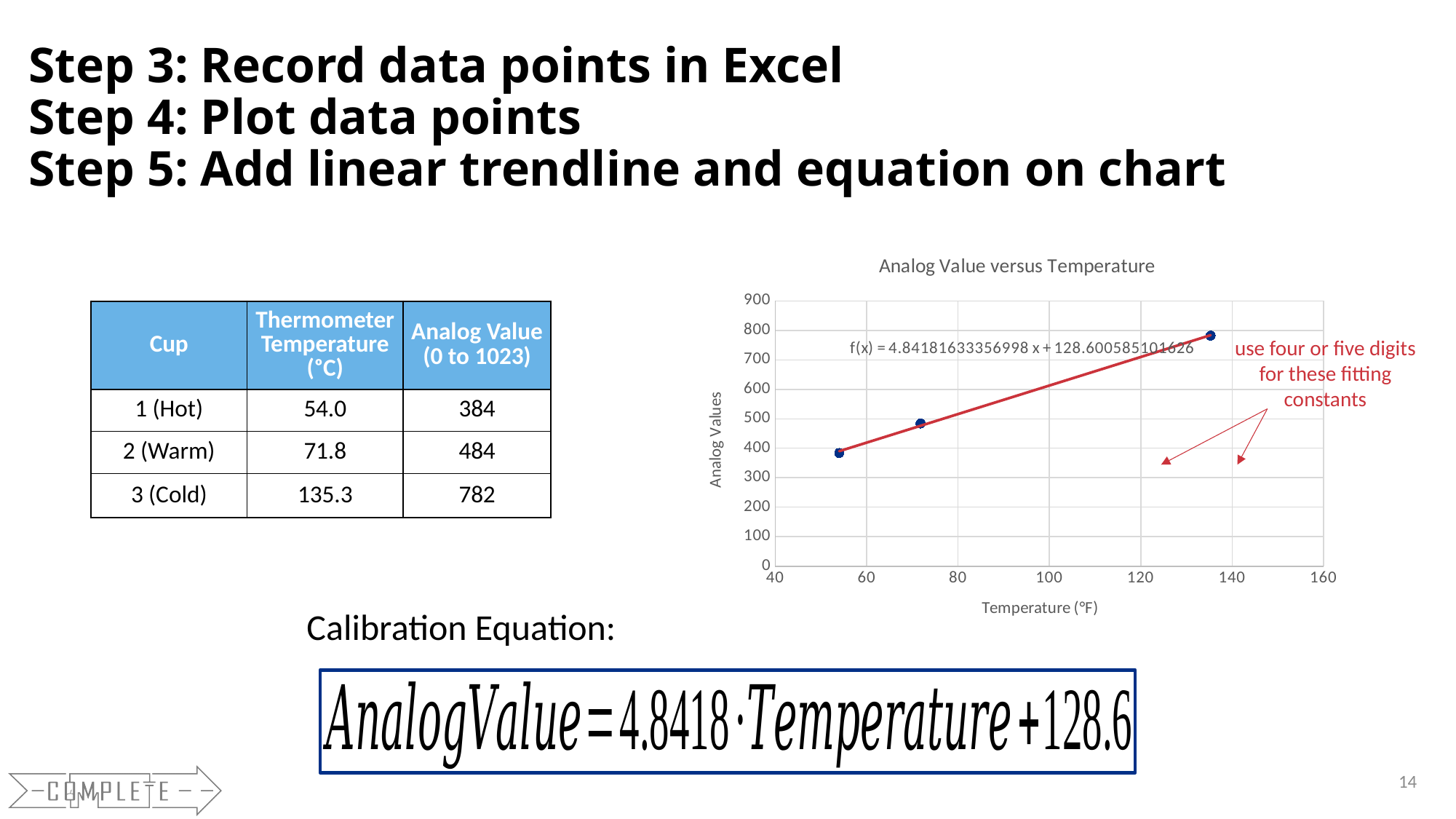
Is the analog value of the rightmost data point (near 135 °F) greater or less than 700? greater Do the analog values rise or fall as temperature increases along the x axis? rise Is the analog value of the leftmost data point (near 54 °F) greater or less than 300? greater What is the label of the x axis of the chart? Temperature (°F) What is the lowest tick value shown on the x axis of the chart? 40 What is the highest tick value shown on the y axis of the chart? 900 Which data point has the higher analog value: the one near 54 °F or the one near 135 °F? the one near 135 °F What is the slope shown in the trendline equation on the chart? 4.84181633356998 Is the analog value of the middle data point (near 72 °F) greater or less than 600? less What kind of chart is shown on the slide? scatter chart How many data points are plotted on the chart? 3 What is the title of the chart? Analog Value versus Temperature